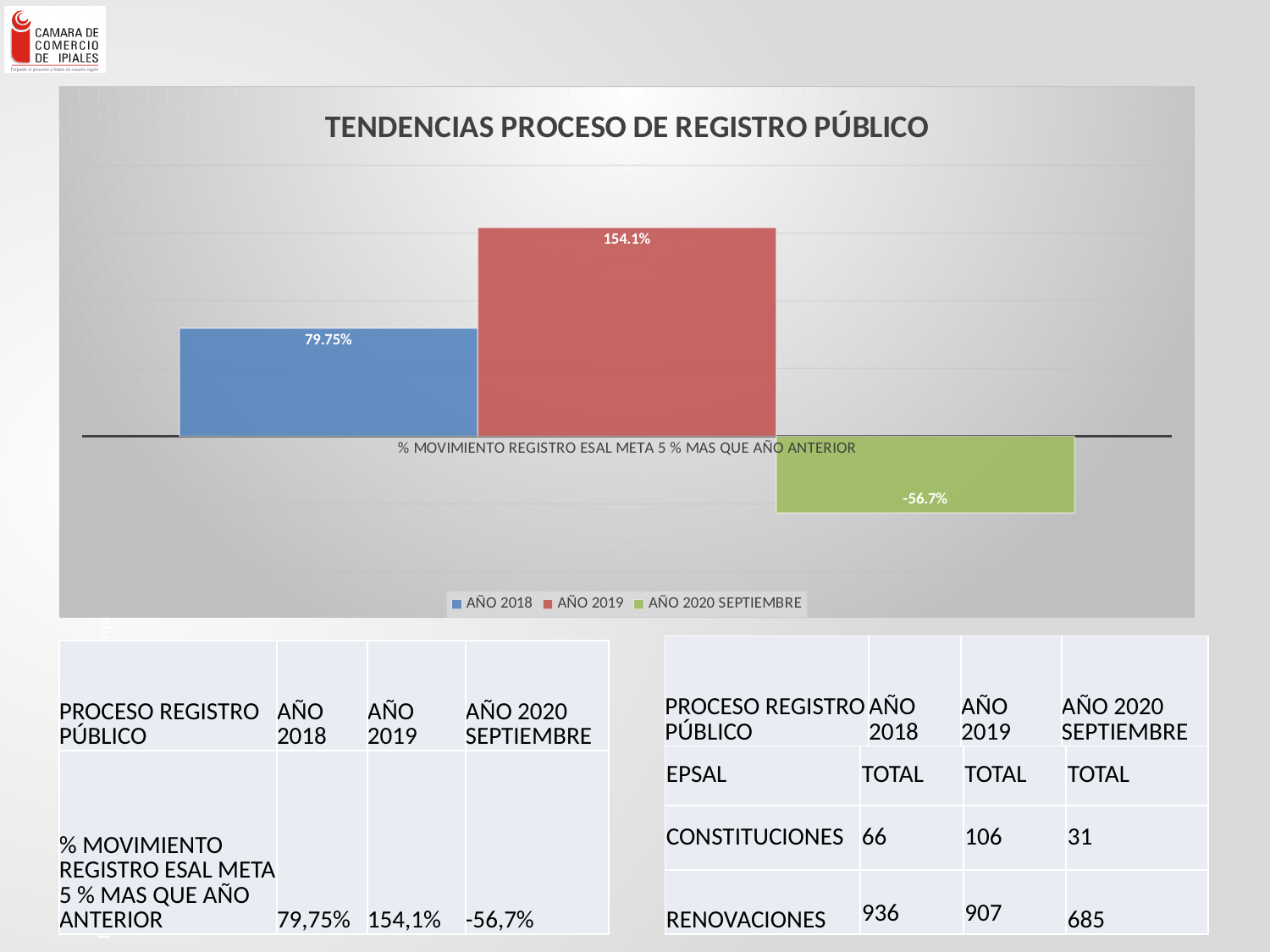
Which is larger, the value for AÑO 2018 or the value for AÑO 2020 SEPTIEMBRE? AÑO 2018 What is the value for AÑO 2020 SEPTIEMBRE in the chart? -56.7% What is the value for AÑO 2019 in the chart? 154.1% Which colour represents AÑO 2020 SEPTIEMBRE in the chart? Green What is the value for AÑO 2018 in the chart? 79.75% Which series has the lowest value in the chart? AÑO 2020 SEPTIEMBRE How many series does the legend list? 3 How many categories are shown on the x axis of the chart? 1 What is the difference between the AÑO 2019 value and the AÑO 2018 value? 74.35% Which series has the highest value in the chart? AÑO 2019 What is the title of the chart? TENDENCIAS PROCESO DE REGISTRO PÚBLICO What kind of chart is shown on the slide? Bar chart